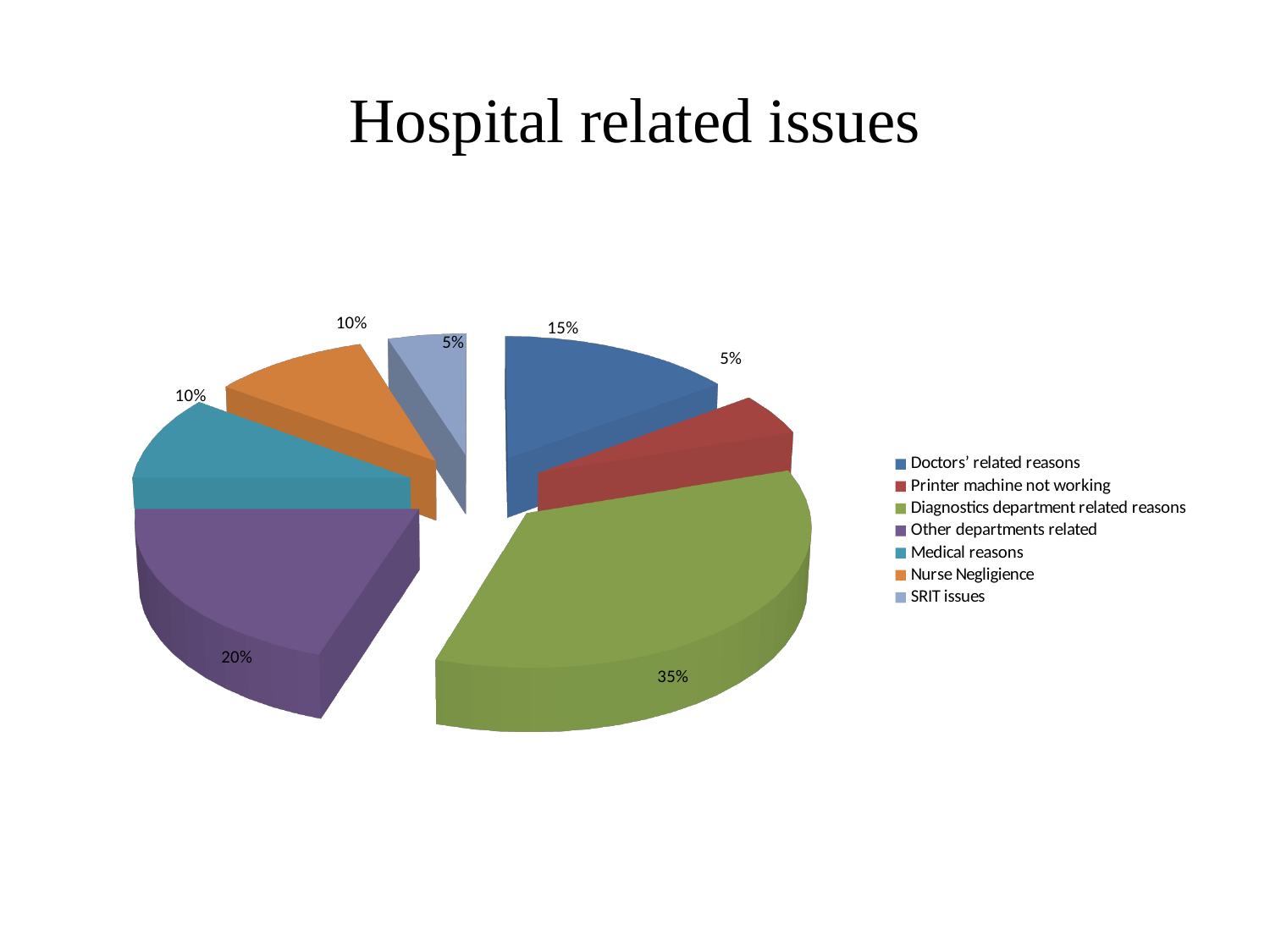
What is the title of the chart? Hospital related issues What share of the pie is Diagnostics department related reasons? 35% Which category has the largest share of the pie? Diagnostics department related reasons What kind of chart is shown on the slide? pie chart What colour is the slice for Nurse Negligience? orange What share of the pie is Doctors' related reasons? 15% What is the difference between the shares for Diagnostics department related reasons and Other departments related? 15% What share of the pie is SRIT issues? 5% How many categories does the legend list? 7 Which is larger, the share for Doctors' related reasons or the share for Printer machine not working? Doctors' related reasons